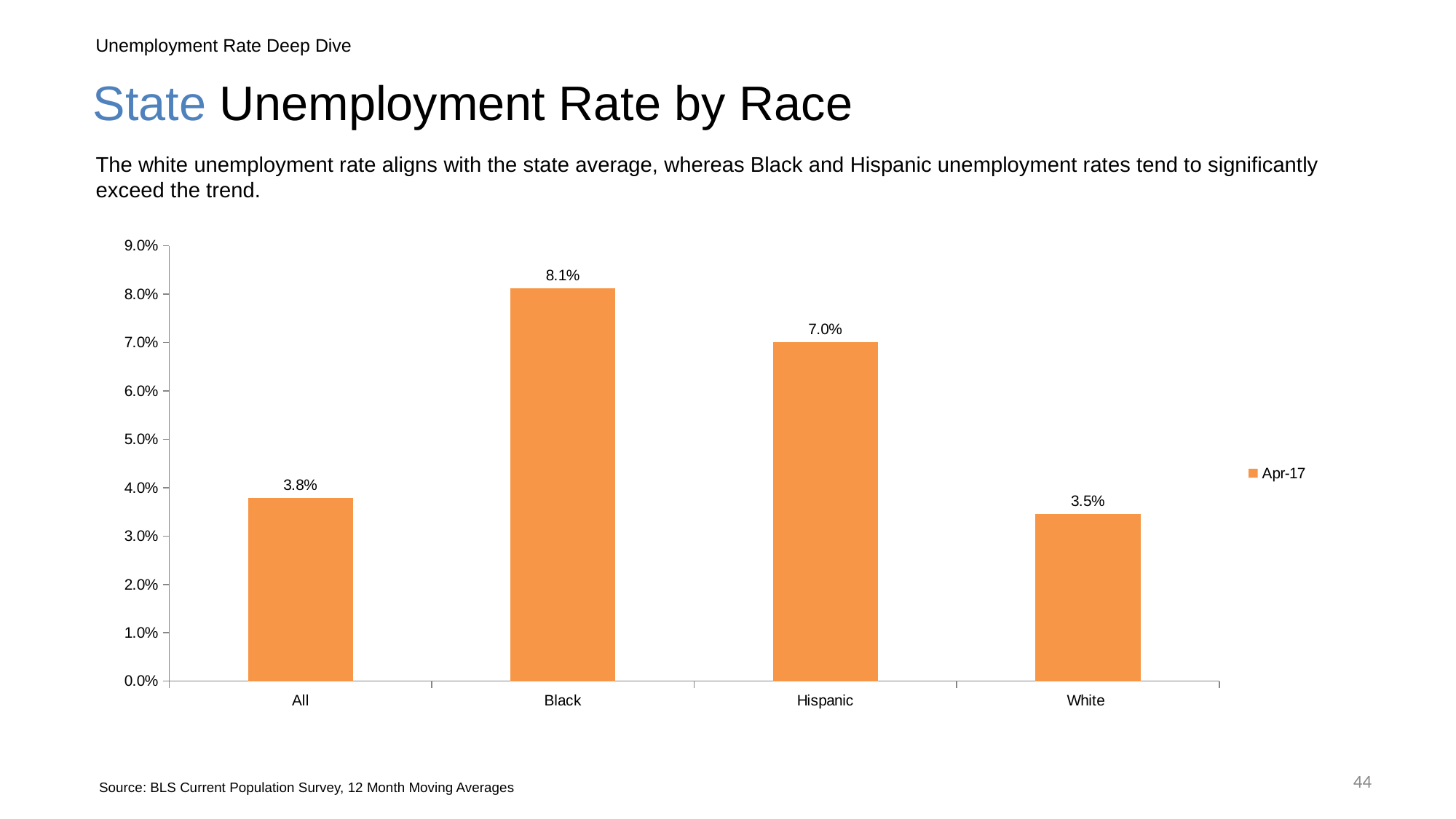
Is the value for Hispanic greater or less than 6.0%? greater What is the unemployment rate for Hispanic? 7.0% Which is larger, the unemployment rate for Hispanic or for All? Hispanic What is the unemployment rate for Black in Apr-17? 8.1% What is the unemployment rate for White? 3.5% How many categories are shown on the x axis? 4 Which category has the highest unemployment rate? Black Which category has the lowest unemployment rate? White How many series does the legend list? 1 What kind of chart is shown on the slide? Bar chart What is the unemployment rate for the All category? 3.8% What is the difference between the Black and White unemployment rates? 4.6%